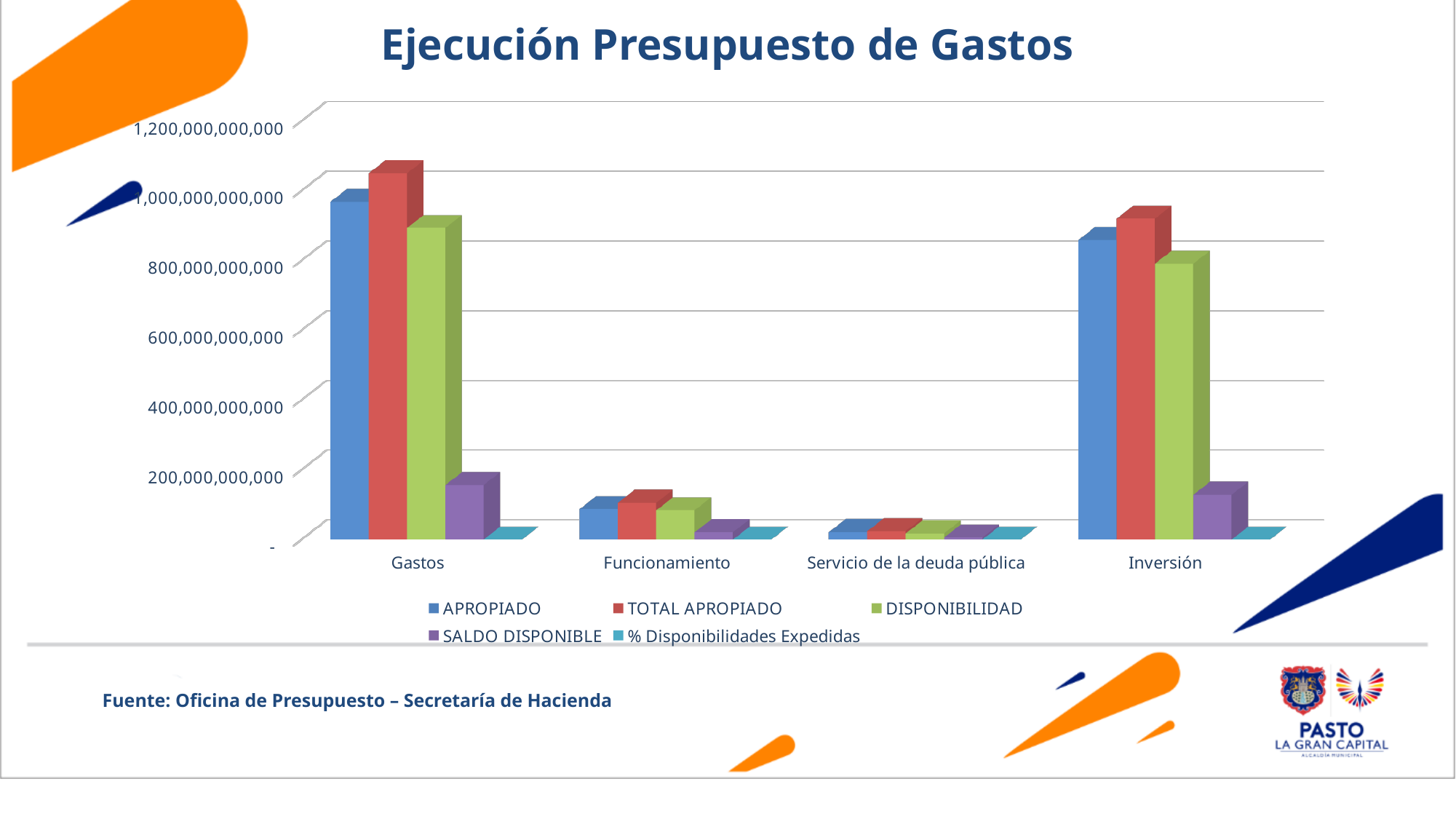
What is the title of the chart? Ejecución Presupuesto de Gastos Which category has the larger TOTAL APROPIADO value, Gastos or Inversión? Gastos Which category has the highest APROPIADO value? Gastos Which category has the larger APROPIADO value, Funcionamiento or Servicio de la deuda pública? Funcionamiento Is the APROPIADO value for Inversión greater or less than 800,000,000,000? greater What kind of chart is shown on the slide? Bar chart How many categories are shown on the x axis of the chart? 4 How many series does the chart's legend list? 5 Which series is shown in green in the chart's legend? DISPONIBILIDAD Is the TOTAL APROPIADO value for Gastos greater or less than 1,000,000,000,000? greater Is the TOTAL APROPIADO value for Funcionamiento greater or less than 200,000,000,000? less Which category has the lowest TOTAL APROPIADO value? Servicio de la deuda pública